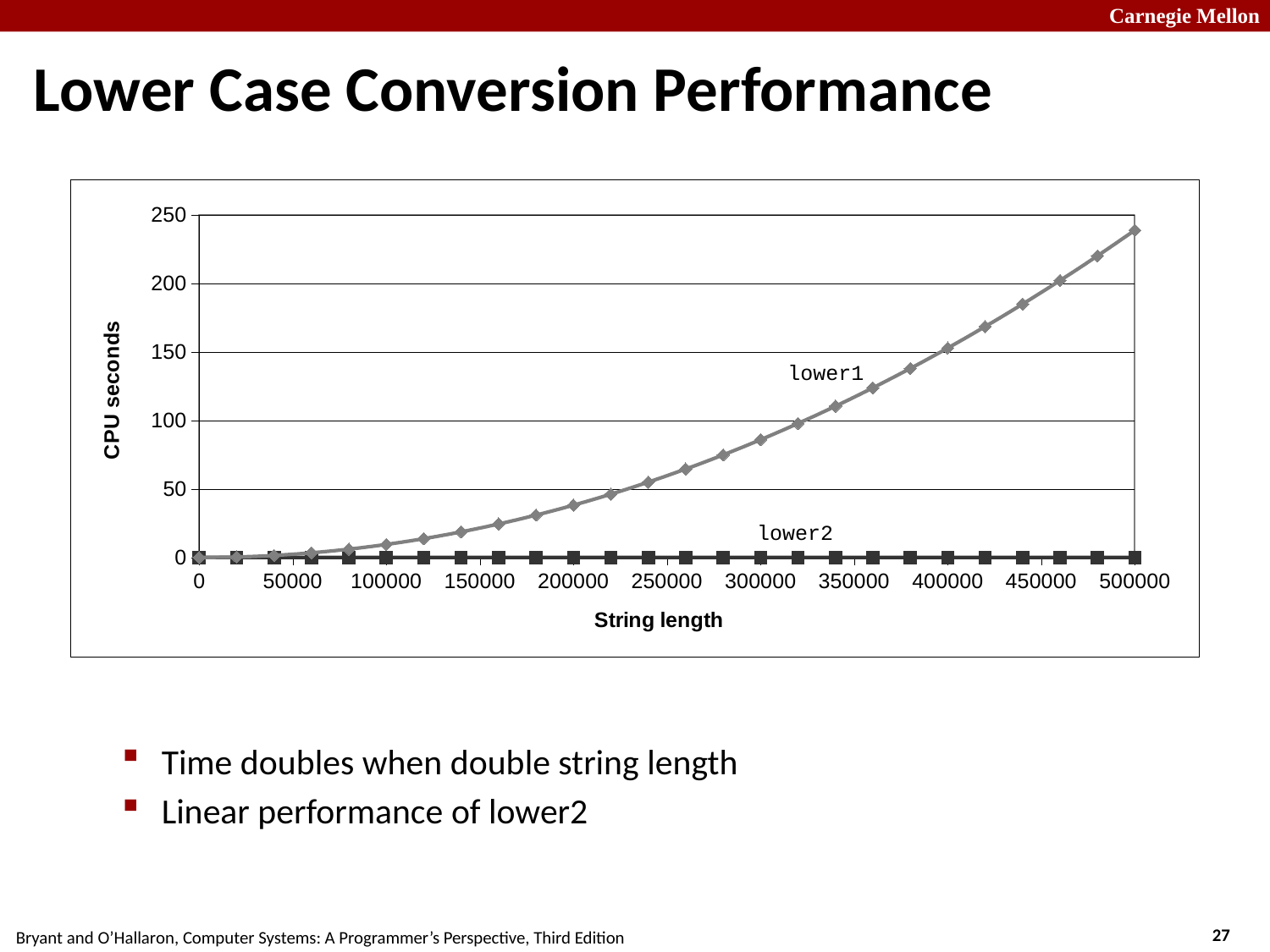
Which series reaches the highest CPU seconds on the chart? lower1 Is the CPU seconds value for lower1 at a string length of 300000 greater or less than 100? less What is the title of the chart's y axis? CPU seconds Is the CPU seconds value for lower1 at a string length of 500000 greater or less than 200? greater Does the CPU time for lower1 rise or fall as string length increases? rise Which series has the higher CPU seconds at a string length of 500000, lower1 or lower2? lower1 Is the CPU seconds value for lower1 at a string length of 250000 greater or less than 100? less What kind of chart is shown on the slide? line chart How many data series are plotted on the chart? 2 Which series stays lowest in CPU seconds across all string lengths? lower2 What is the title of the chart's x axis? String length